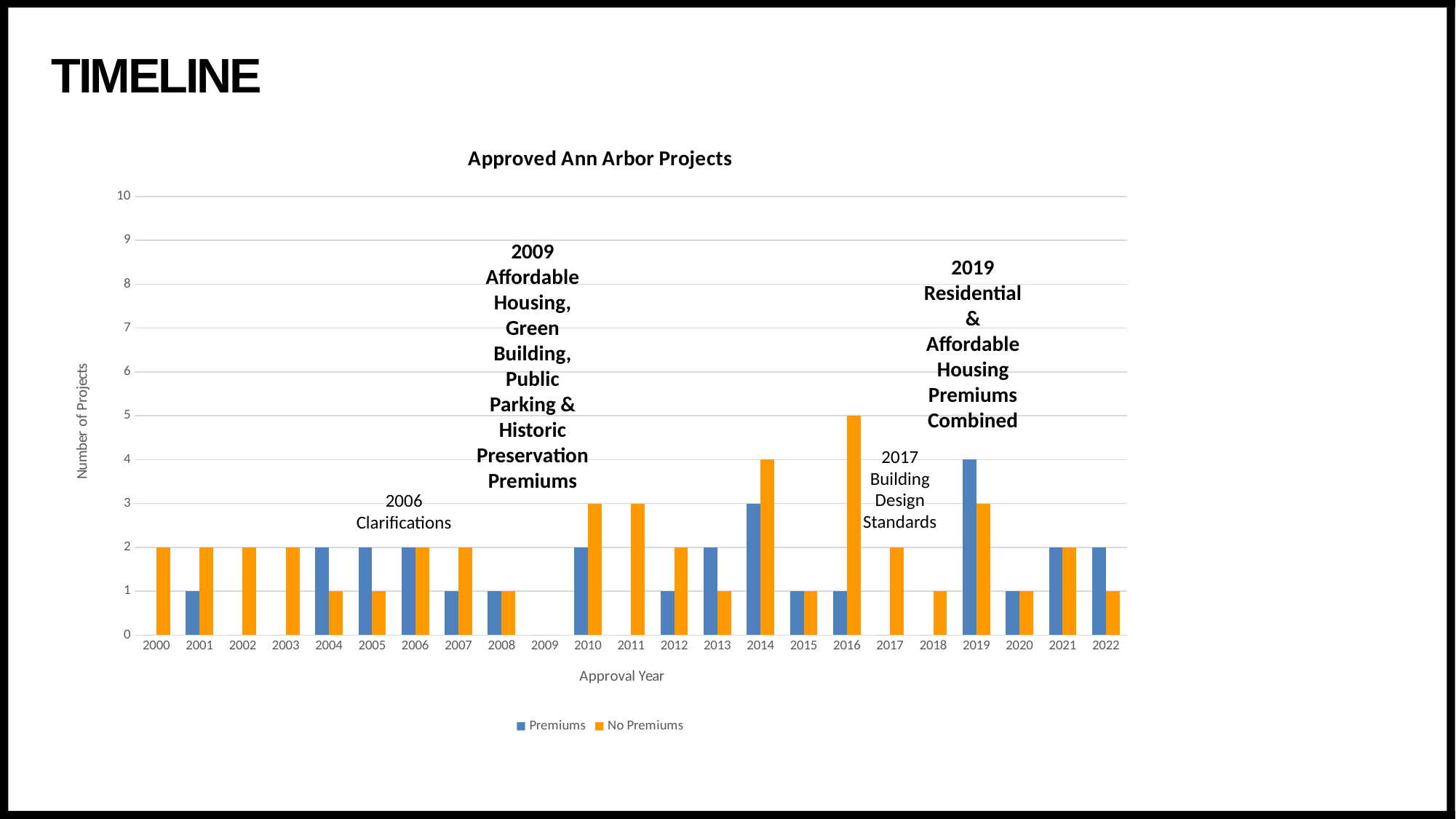
Which year has the highest Premiums value? 2019 What is the label of the y axis? Number of Projects What type of chart is shown on the slide? bar chart How many approval years are shown on the x axis of the chart? 23 What is the difference between the No Premiums and Premiums values in 2016? 4 What is the No Premiums value for 2014? 4 What is the Premiums value for 2019? 4 What is the title of the chart? Approved Ann Arbor Projects Which year has the highest No Premiums value? 2016 How many series does the legend list in the Approved Ann Arbor Projects chart? 2 Which is larger in 2016, Premiums or No Premiums? No Premiums What is the No Premiums value for 2016? 5